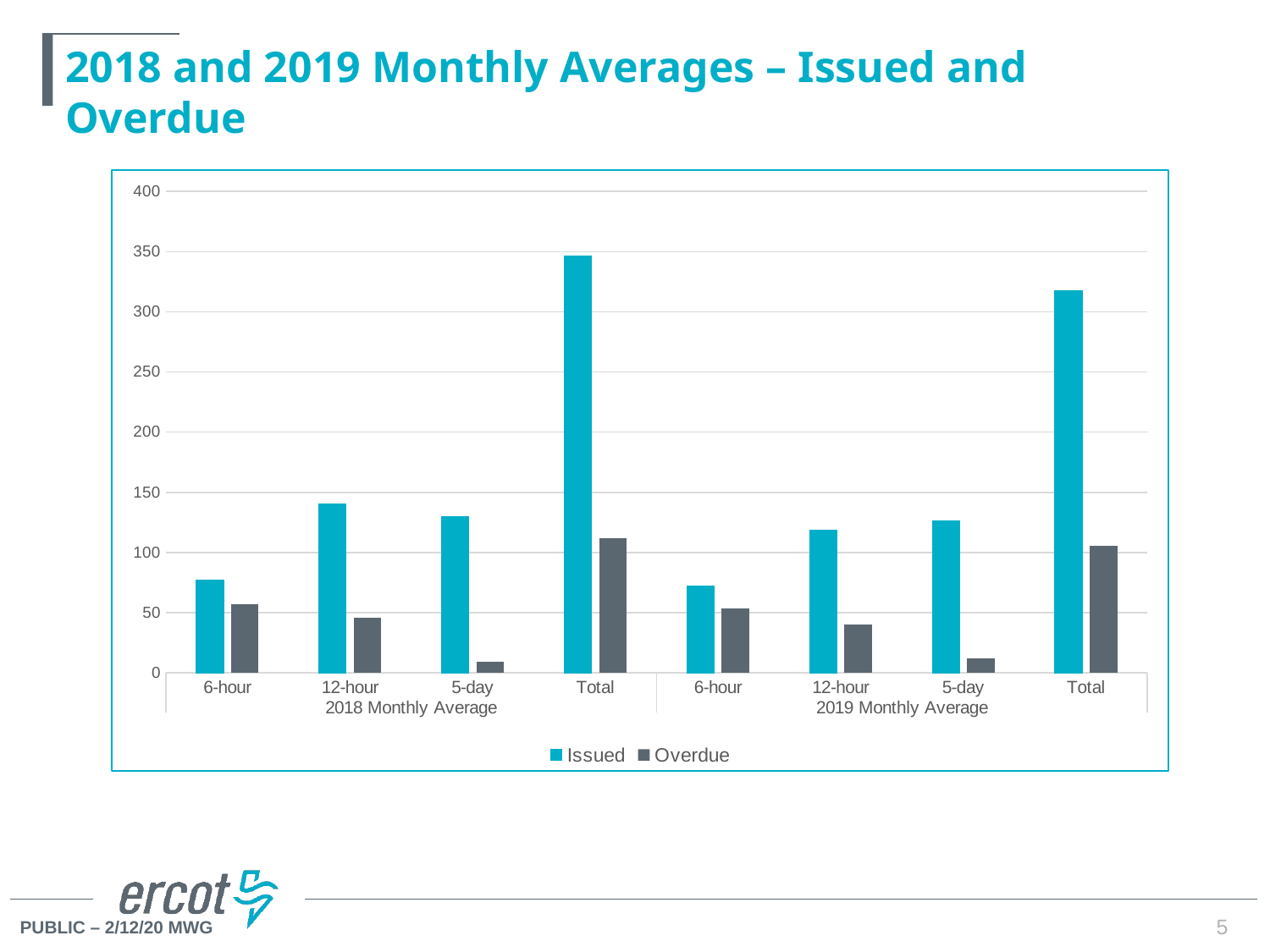
Is the Overdue value for Total in the 2019 Monthly Average greater or less than 150? less Which category has the highest Issued value? Total (2018 Monthly Average) Which series is shown in the teal (light blue) colour? Issued Which is larger, the Issued value for 12-hour in 2018 Monthly Average or the Issued value for 12-hour in 2019 Monthly Average? 12-hour in 2018 Monthly Average Is the Issued value for 6-hour in the 2019 Monthly Average greater or less than 100? less How many series does the legend list? 2 What kind of chart is shown on the slide? Bar chart Which is larger, the Issued value for Total in 2018 Monthly Average or the Issued value for Total in 2019 Monthly Average? Total in 2018 Monthly Average Is the Issued value for Total in the 2018 Monthly Average greater or less than 300? greater How many categories are plotted along the x axis? 8 Within the 2018 Monthly Average group, which category has the lowest Overdue value? 5-day